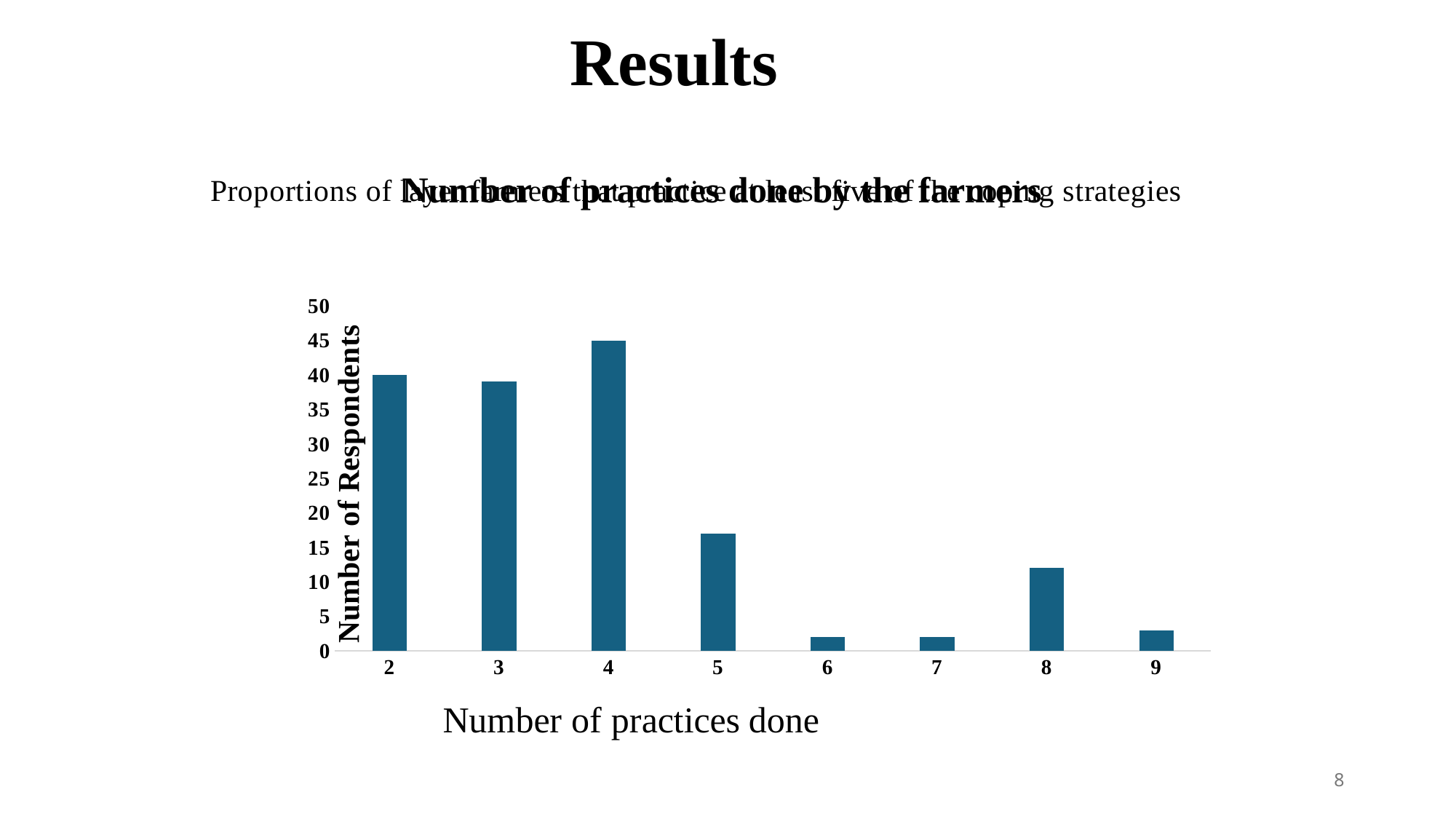
What is the number of respondents for 2 practices done? 40 Which has more respondents: 8 practices done or 9 practices done? 8 What is the number of respondents for 4 practices done? 45 How many categories are shown on the x axis of the chart? 8 Which has more respondents: 2 practices done or 5 practices done? 2 Overall, do the number of respondents rise or fall as the number of practices done increases from 4 to 9? fall Which number of practices done has the highest number of respondents? 4 Is the number of respondents for 9 practices done greater or less than 5? less What kind of chart is shown on the slide? bar chart Is the number of respondents for 5 practices done greater or less than 20? less What is the label of the y axis of the chart? Number of Respondents Is the number of respondents for 8 practices done greater or less than 10? greater